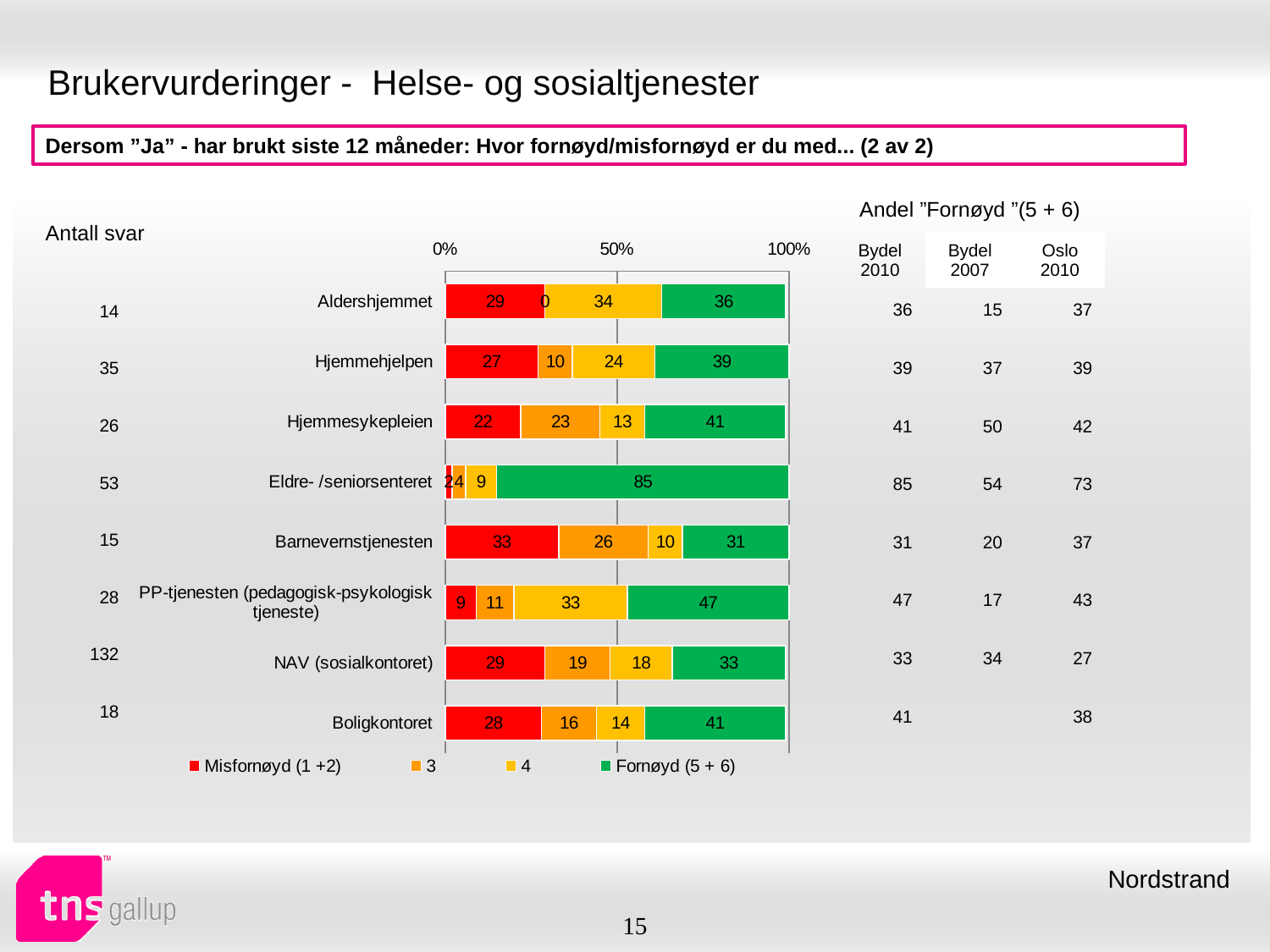
What is the value of series 4 for PP-tjenesten (pedagogisk-psykologisk tjeneste)? 33 What is the value of series 3 for Hjemmesykepleien? 23 Which category has the highest Fornøyd (5 + 6) value? Eldre- /seniorsenteret What is the first entry in the chart legend? Misfornøyd (1 +2) What is the difference between the Fornøyd (5 + 6) values for Eldre- /seniorsenteret and Aldershjemmet? 49 What kind of chart is shown on the slide? bar chart Which has the larger Misfornøyd (1 +2) value, Aldershjemmet or Hjemmehjelpen? Aldershjemmet What is the Misfornøyd (1 +2) value for Barnevernstjenesten? 33 What is the Fornøyd (5 + 6) value for Eldre- /seniorsenteret? 85 Which category has the lowest Fornøyd (5 + 6) value? Barnevernstjenesten How many series does the chart legend list? 4 How many categories (services) are plotted in the bar chart? 8